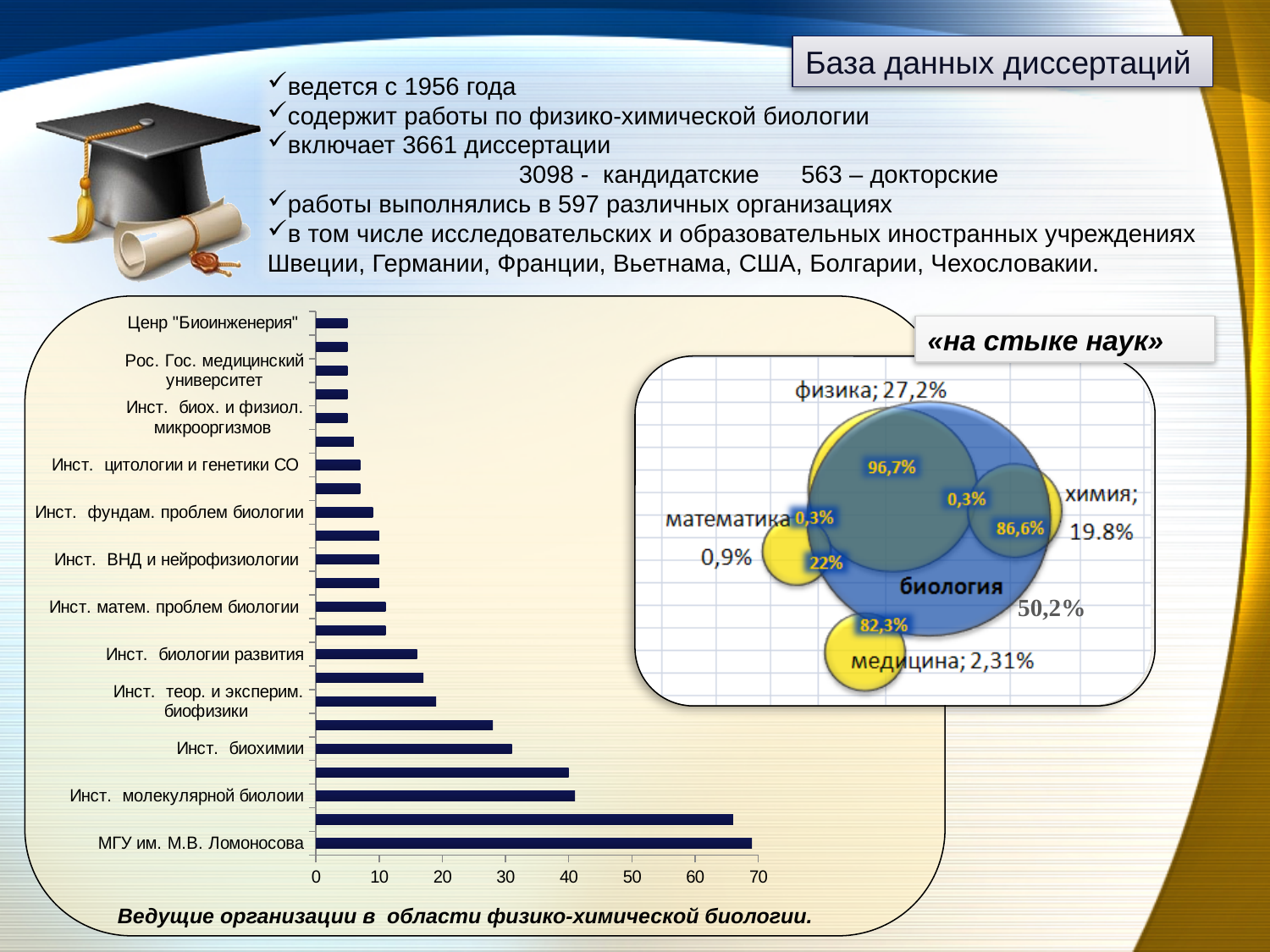
On the chart 'на стыке наук', what percentage is shown for биология? 50,2% On the chart 'на стыке наук', what percentage is shown for физика? 27,2% What kind of chart is 'Ведущие организации в области физико-химической биологии'? bar chart On the bar chart 'Ведущие организации в области физико-химической биологии', is the value for Инст. молекулярной биологии greater or less than 30? greater On the bar chart 'Ведущие организации в области физико-химической биологии', is the value for Ценр "Биоинженерия" greater or less than 10? less On the chart 'на стыке наук', what percentage is shown for медицина? 2,31% On the bar chart 'Ведущие организации в области физико-химической биологии', which is larger: the value for МГУ им. М.В. Ломоносова or for Инст. биохимии? МГУ им. М.В. Ломоносова On the bar chart 'Ведущие организации в области физико-химической биологии', is the value for МГУ им. М.В. Ломоносова greater or less than 60? greater On the bar chart 'Ведущие организации в области физико-химической биологии', which organization has the highest value? МГУ им. М.В. Ломоносова On the chart 'на стыке наук', which field has the smallest percentage? математика On the chart 'на стыке наук', what percentage is shown for химия? 19.8%